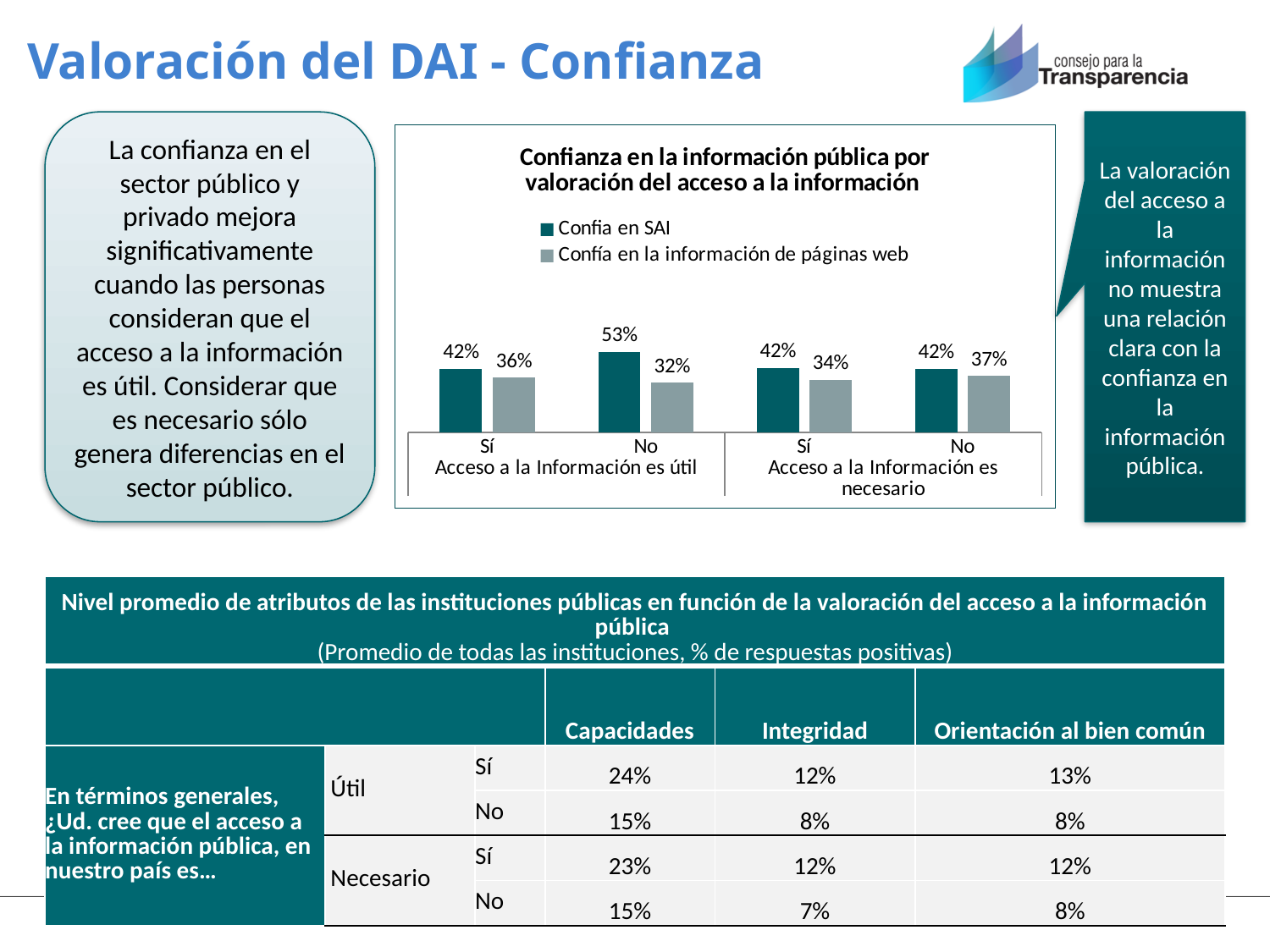
What is the value of 'Confia en SAI' for 'No' under 'Acceso a la Información es útil'? 53% What is the value of 'Confía en la información de páginas web' for 'No' under 'Acceso a la Información es necesario'? 37% What is the value of 'Confía en la información de páginas web' for 'Sí' under 'Acceso a la Información es útil'? 36% What type of chart is shown on the slide? bar chart How many series does the chart legend list? 2 Which category has the highest value for 'Confia en SAI'? No (Acceso a la Información es útil) Which category has the lowest value for 'Confía en la información de páginas web'? No (Acceso a la Información es útil) What is the title of the chart? Confianza en la información pública por valoración del acceso a la información What is the difference between 'Confia en SAI' and 'Confía en la información de páginas web' for 'No' under 'Acceso a la Información es útil'? 21% What is the value of 'Confia en SAI' for 'Sí' under 'Acceso a la Información es necesario'? 42% How many category groups (bar pairs) are plotted in the chart? 4 For 'Sí' under 'Acceso a la Información es necesario', which series has the larger value, 'Confia en SAI' or 'Confía en la información de páginas web'? Confia en SAI